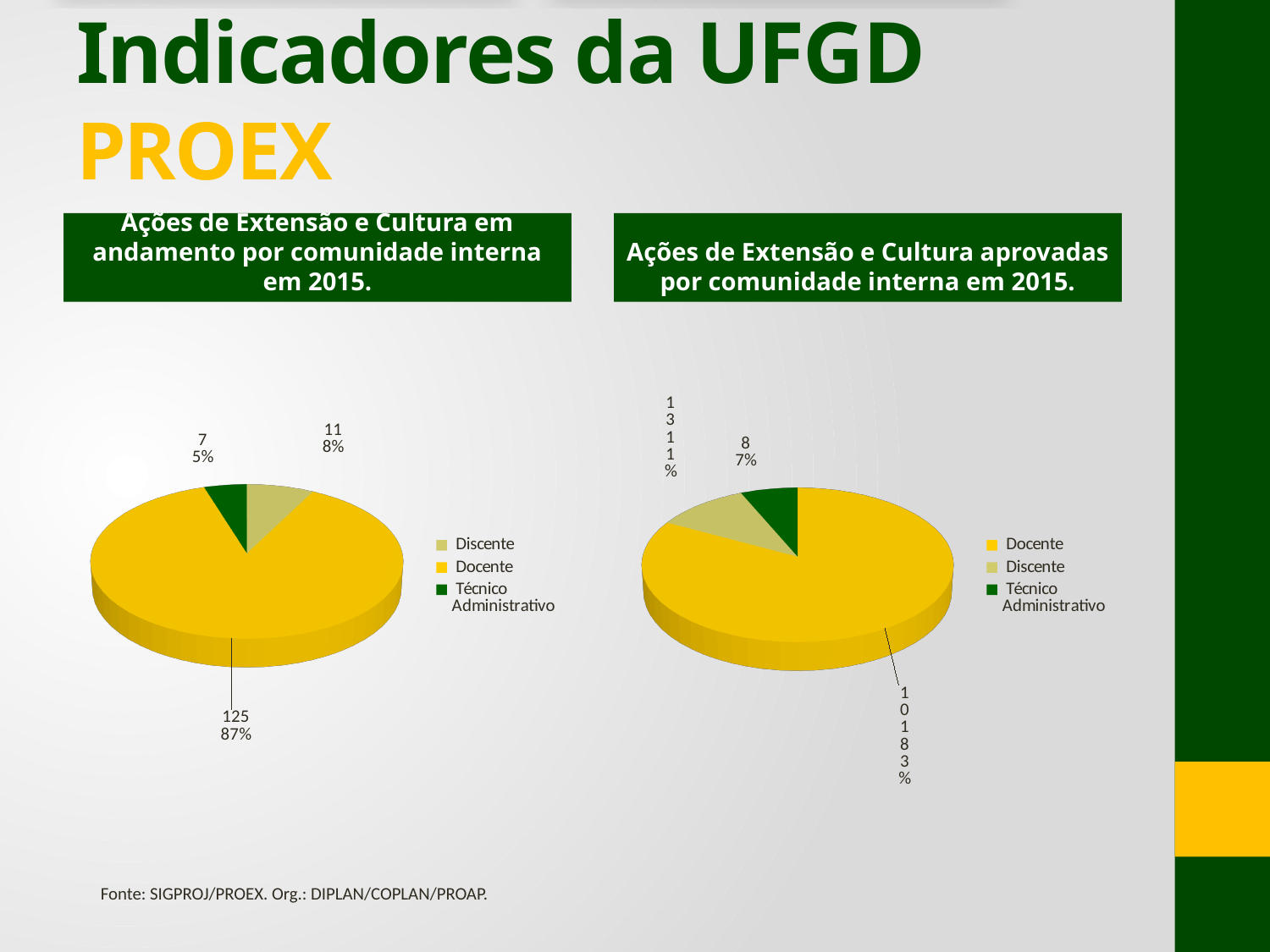
What type of chart is used for the left chart (Ações de Extensão e Cultura em andamento)? Pie chart In the left chart (Ações de Extensão e Cultura em andamento), what is the difference between the Docente value and the Discente value? 114 In the left chart (Ações de Extensão e Cultura em andamento), which category has the smallest slice? Técnico Administrativo In the right chart (Ações de Extensão e Cultura aprovadas por comunidade interna em 2015), what value is shown for Docente? 101 In the left chart (Ações de Extensão e Cultura em andamento), what percentage share does Discente have? 8% How many categories does the legend of the right chart (Ações de Extensão e Cultura aprovadas) list? 3 In the right chart (Ações de Extensão e Cultura aprovadas), what percentage share does Técnico Administrativo have? 7% In the right chart (Ações de Extensão e Cultura aprovadas), what value is shown for Discente? 13 In the right chart (Ações de Extensão e Cultura aprovadas), which is larger, the Discente slice or the Técnico Administrativo slice? Discente In the left chart (Ações de Extensão e Cultura em andamento), what value is shown for Técnico Administrativo? 7 In the left chart (Ações de Extensão e Cultura em andamento), which category has the largest slice? Docente In the left chart (Ações de Extensão e Cultura em andamento por comunidade interna em 2015), what value is shown for Docente? 125